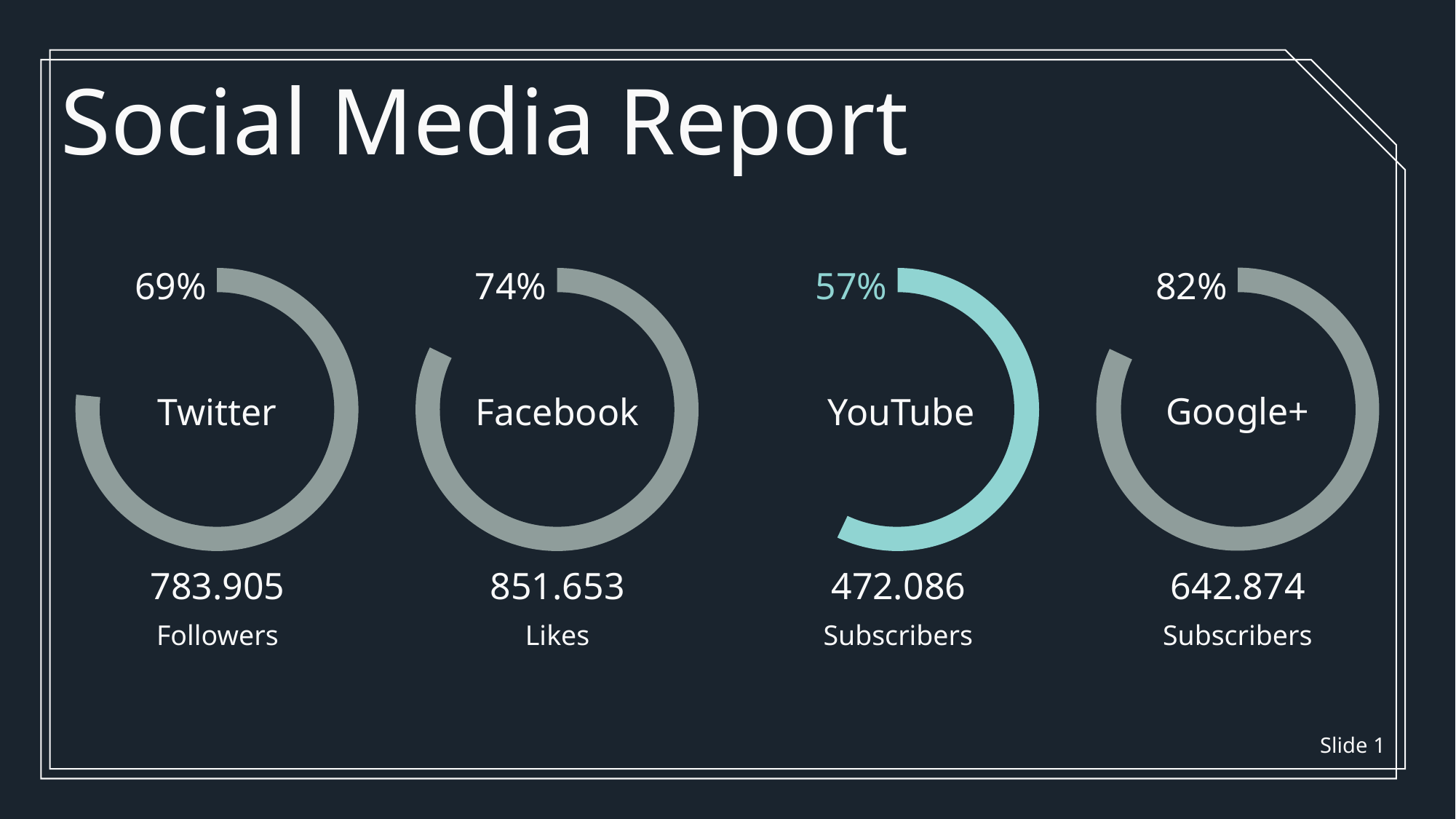
What percentage is shown on the Twitter ring chart? 69% Which platform's ring chart shows the highest percentage? Google+ What percentage is shown on the Facebook ring chart? 74% What is the difference in percentage points between the Google+ ring chart and the YouTube ring chart? 25 What number of Subscribers is shown below the YouTube ring chart? 472.086 Which ring chart shows a larger percentage, Twitter or Facebook? Facebook Which ring chart is drawn in a different (teal) colour from the others? YouTube What percentage is shown on the Google+ ring chart? 82% What percentage is shown on the YouTube ring chart? 57% How many ring charts are shown on the slide? 4 What number of Followers is shown below the Twitter ring chart? 783.905 Which platform's ring chart shows the lowest percentage? YouTube